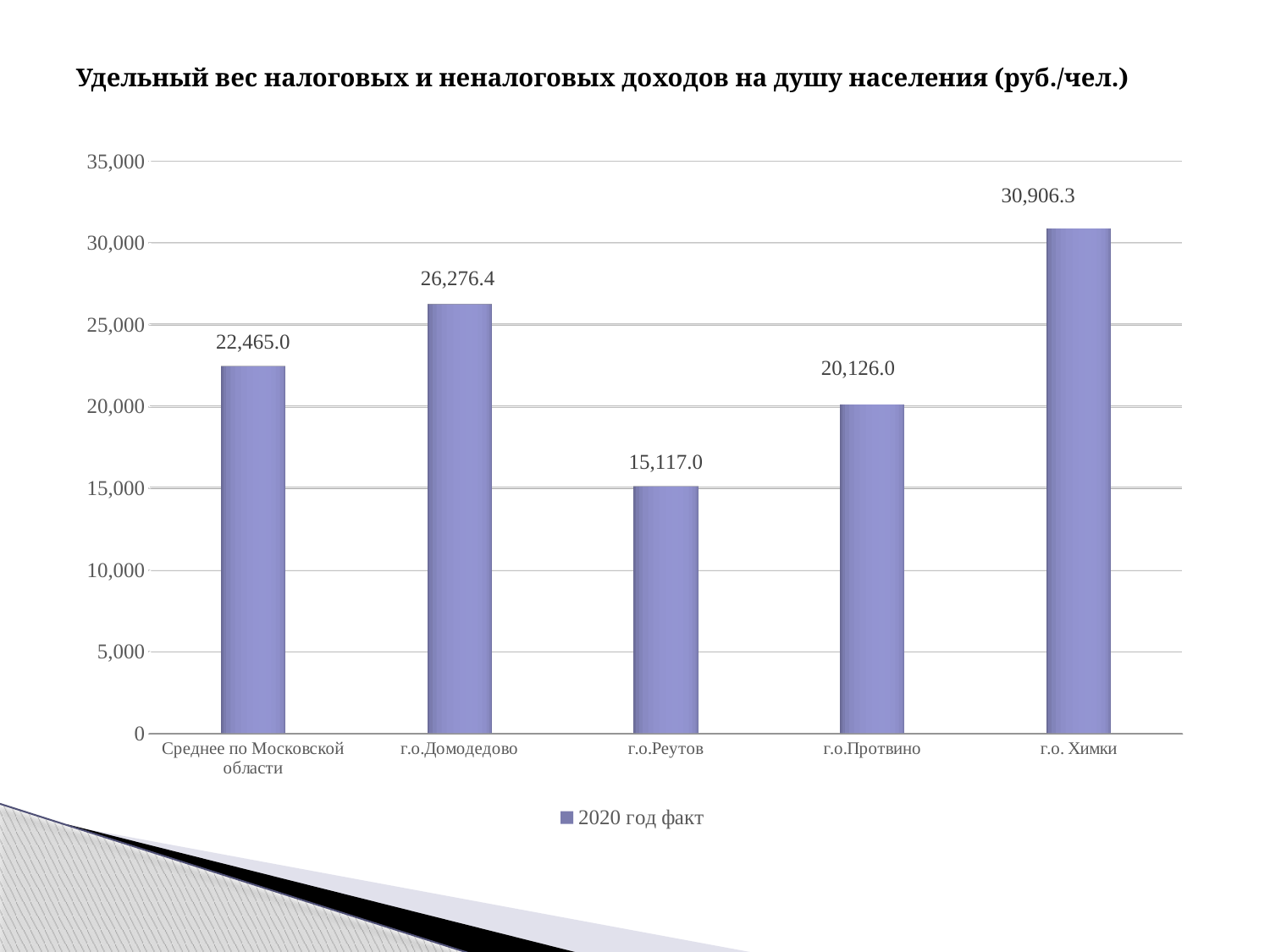
What is the value for Среднее по Московской области? 22,465.0 What is the difference between the values for г.о.Домодедово and Среднее по Московской области? 3,811.4 What is the value for г.о.Реутов? 15,117.0 What is the difference between the values for г.о. Химки and г.о.Реутов? 15,789.3 Is the value for г.о.Протвино greater or less than 25,000? less What is the value for г.о. Химки? 30,906.3 What kind of chart is shown on the slide? bar chart How many categories are shown on the x axis? 5 What is the value for г.о.Протвино? 20,126.0 Which category has the lowest value? г.о.Реутов Which is larger, the value for г.о.Домодедово or the value for г.о.Протвино? г.о.Домодедово Which category has the highest value? г.о. Химки